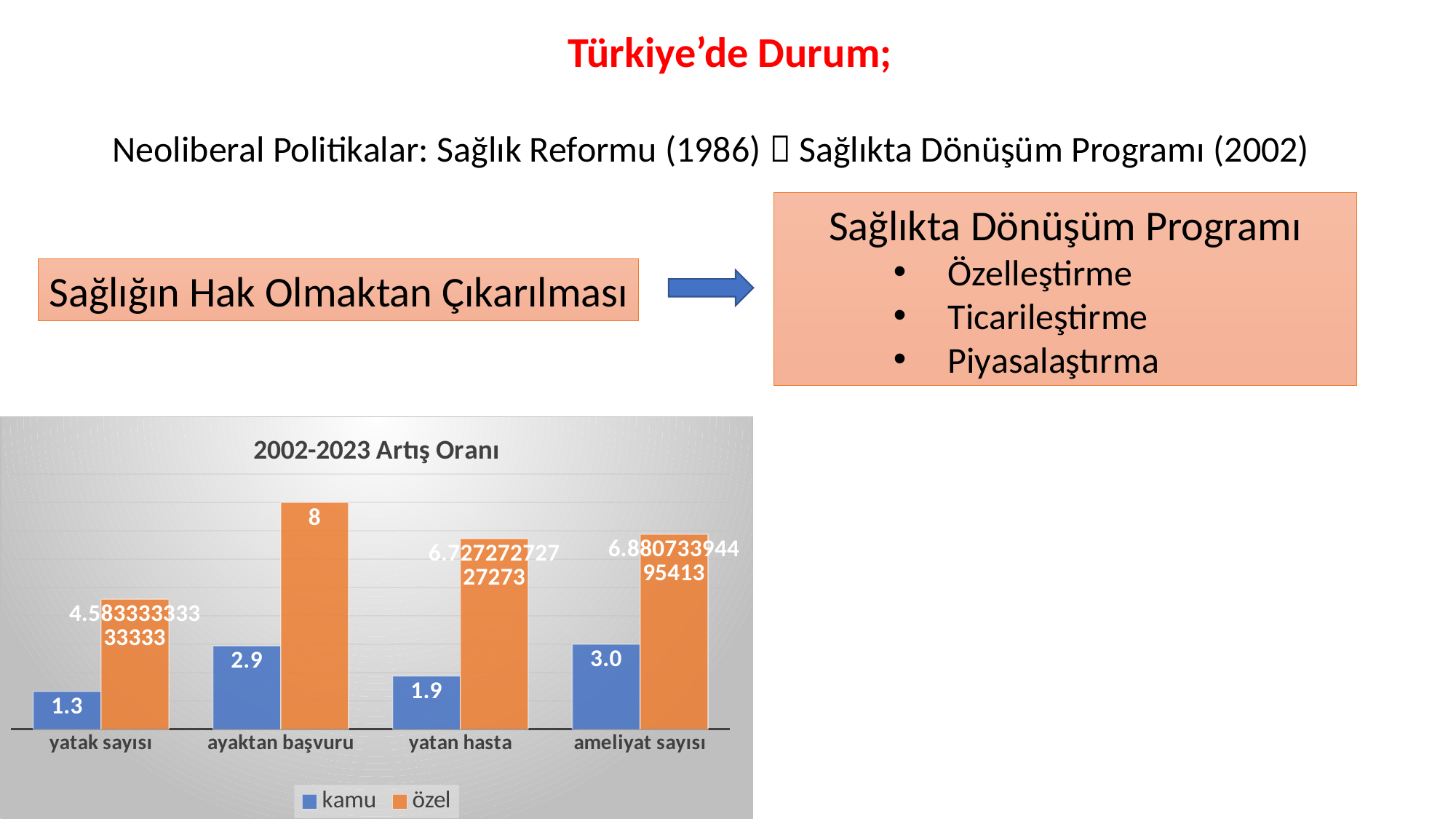
Which category has the highest value for the kamu series? ameliyat sayısı What is the title of the chart? 2002-2023 Artış Oranı How many series does the chart legend list? 2 What is the value for kamu in the ameliyat sayısı category? 3.0 In the yatan hasta category, which series has the larger value, kamu or özel? özel How many categories are shown on the x axis of the chart? 4 Which category has the highest value for the özel series? ayaktan başvuru What is the value for özel in the ayaktan başvuru category? 8 What is the difference between the kamu values for ayaktan başvuru and yatak sayısı? 1.6 Which category has the lowest value for the kamu series? yatak sayısı What is the value for kamu in the yatak sayısı category? 1.3 What is the value for kamu in the yatan hasta category? 1.9